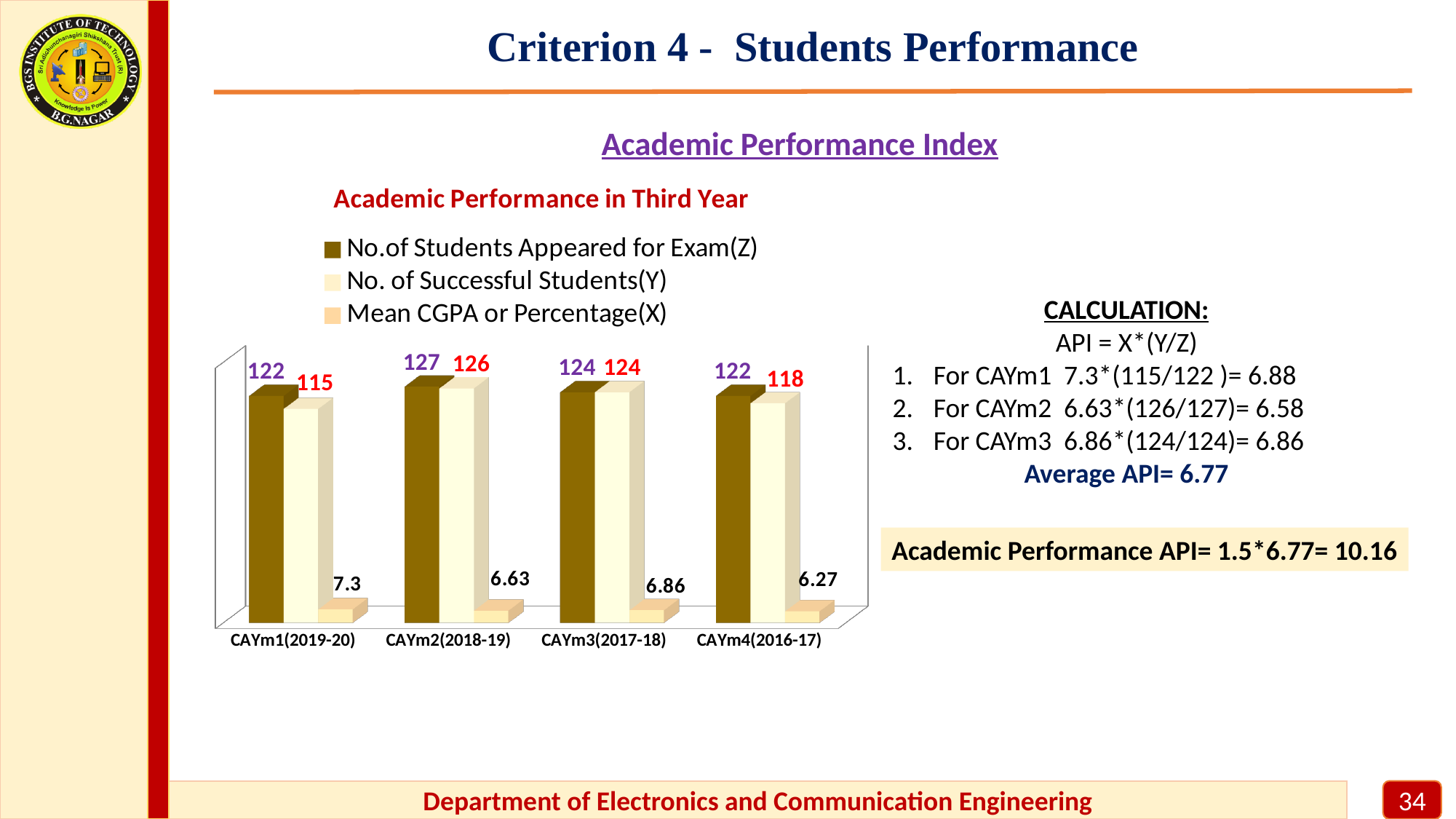
Which category has the lowest mean CGPA or percentage (X)? CAYm4(2016-17) What kind of chart is shown on the slide? Bar chart Which category has the highest mean CGPA or percentage (X)? CAYm1(2019-20) Which is larger for CAYm3(2017-18): the mean CGPA or the mean CGPA for CAYm4(2016-17)? CAYm3(2017-18) What is the number of students appeared for exam (Z) for CAYm1(2019-20)? 122 How many series does the legend list? 3 What is the difference between the number of students appeared for exam and the number of successful students for CAYm1(2019-20)? 7 How many categories are shown on the x axis of the chart? 4 What is the number of successful students (Y) for CAYm4(2016-17)? 118 What is the title of the chart? Academic Performance in Third Year Which category has the highest number of students appeared for exam (Z)? CAYm2(2018-19) What is the mean CGPA or percentage (X) for CAYm2(2018-19)? 6.63